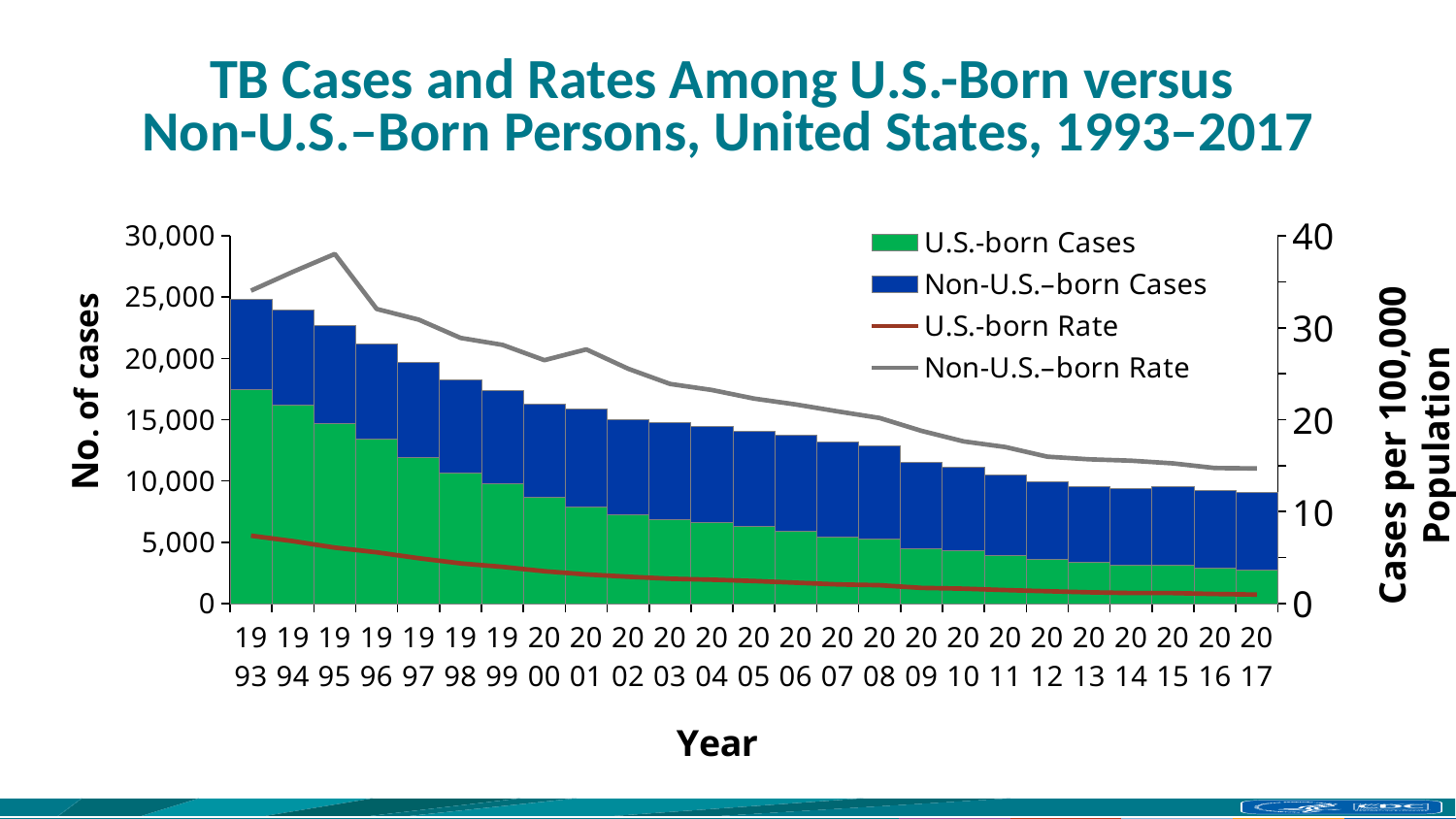
Is the U.S.-born rate in 2017 greater or less than 5 cases per 100,000 population? less Is the total number of cases in 2017 greater or less than 10,000? less In which year is the Non-U.S.-born rate highest? 1995 Is the number of U.S.-born cases in 1993 greater or less than 15,000? greater How many years are shown along the x axis? 25 Do U.S.-born cases rise or fall from 1993 to 2017? Fall What kind of chart is shown on the slide? A combination chart with stacked bars and lines Which year has more U.S.-born cases, 1993 or 2017? 1993 How many series does the legend list? 4 In which year is the total number of TB cases (stacked bar) highest? 1993 What colour represents U.S.-born Cases in the legend? Green